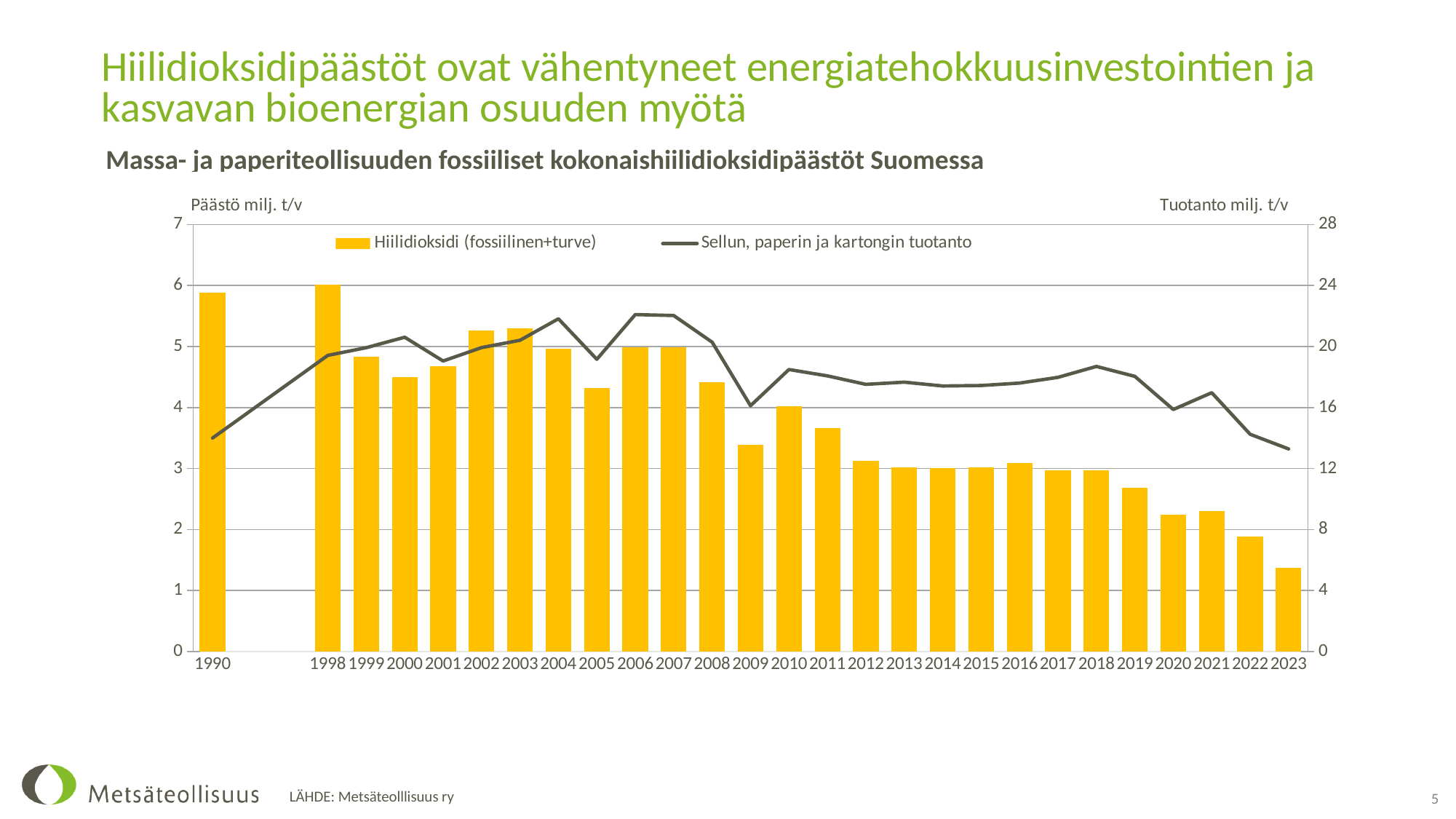
Is the Hiilidioksidi (fossiilinen+turve) value for 2020 greater or less than 2? greater Which year has the larger Hiilidioksidi (fossiilinen+turve) bar, 2019 or 2020? 2019 How many series does the legend list? 2 Is the Hiilidioksidi (fossiilinen+turve) value for 2023 greater or less than 2? less Which year has the larger Hiilidioksidi (fossiilinen+turve) bar, 2009 or 2010? 2010 Which year has the lowest bar for Hiilidioksidi (fossiilinen+turve)? 2023 Is the Hiilidioksidi (fossiilinen+turve) value for 2002 greater or less than 5? greater Overall, do the Hiilidioksidi (fossiilinen+turve) bars rise or fall from 1990 to 2023? fall What kind of chart is shown on the slide? A combined bar and line chart How many years are shown on the x axis? 27 What is the label of the right-hand vertical axis? Tuotanto milj. t/v